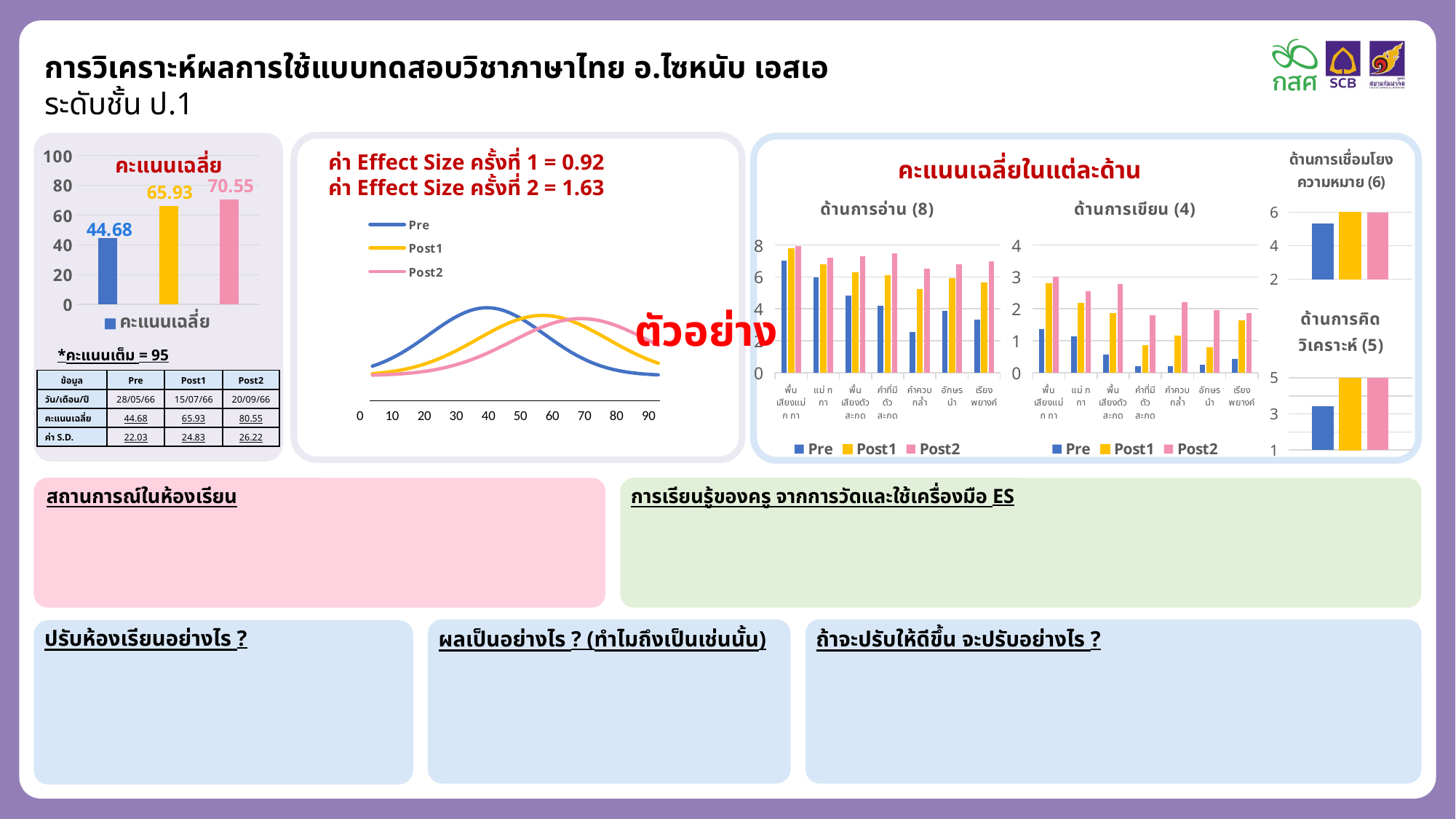
In the คะแนนเฉลี่ย bar chart on the left, which bar is the highest? Post2 In the คะแนนเฉลี่ย bar chart on the left, what is the value of the Post1 bar? 65.93 In the คะแนนเฉลี่ย bar chart on the left, which bar is the lowest? Pre In the คะแนนเฉลี่ย bar chart on the left, how many bars are plotted? 3 What kind of chart is the คะแนนเฉลี่ย chart on the left? bar chart In the คะแนนเฉลี่ย bar chart on the left, what is the value labelled on the Post2 (pink) bar? 70.55 In the คะแนนเฉลี่ย bar chart on the left, what is the value of the Pre bar? 44.68 In the middle chart with the Pre, Post1 and Post2 curves, how many series does the legend list? 3 What kind of chart is the middle chart showing the Pre, Post1 and Post2 curves? line chart In the ด้านการอ่าน (8) chart, is the Pre value for พื้นเสียงแม่ ก กา greater or less than 6? greater In the คะแนนเฉลี่ย bar chart on the left, what is the difference between the Post1 value and the Pre value? 21.25 In the ด้านการเขียน (4) chart, is the Pre value for คำที่มีตัวสะกด greater or less than 1? less